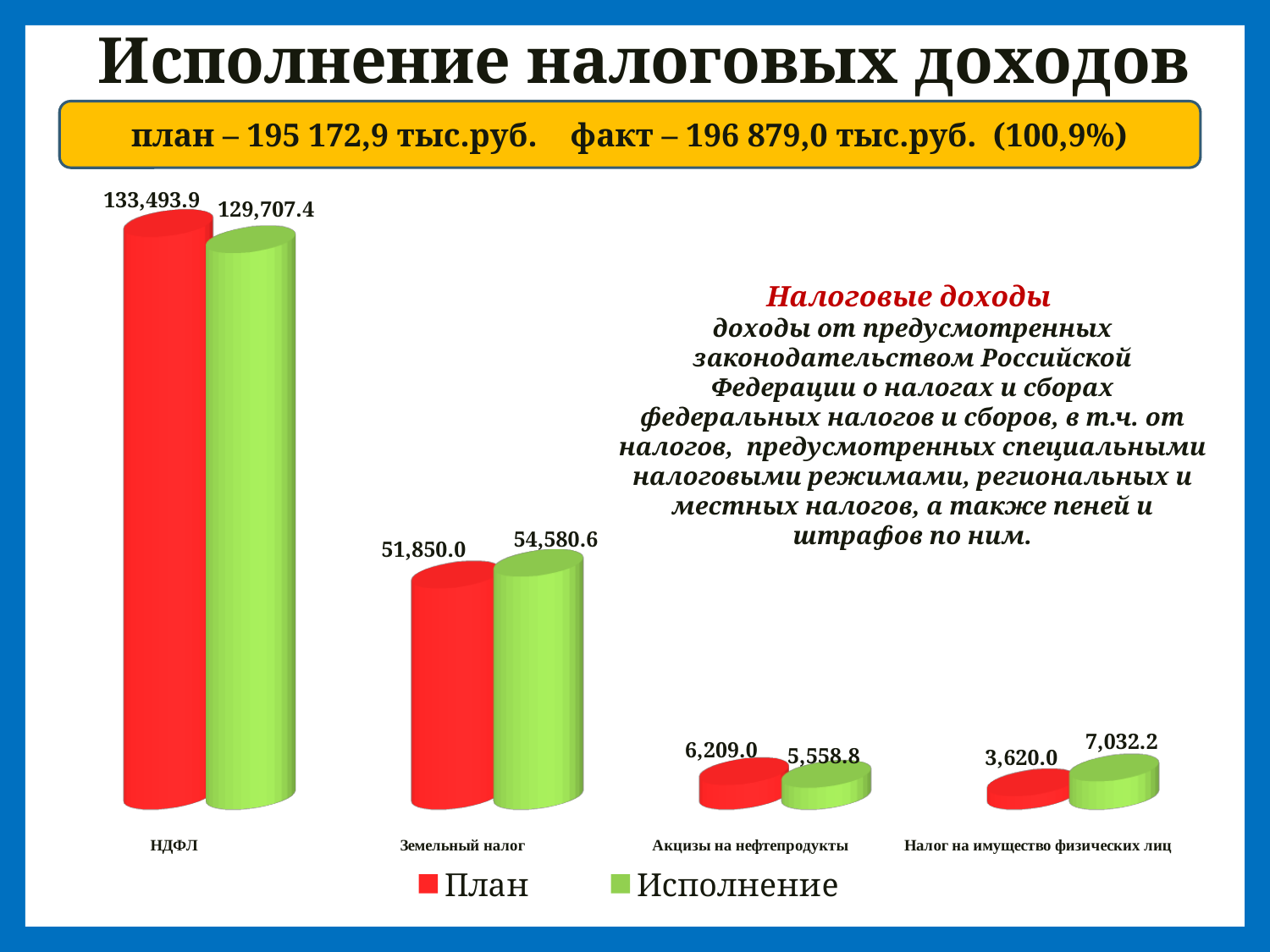
Which category has the lowest План value? Налог на имущество физических лиц What is the План value for НДФЛ? 133,493.9 What is the difference between the Исполнение and План values for Налог на имущество физических лиц? 3,412.2 What is the Исполнение value for Земельный налог? 54,580.6 What is the difference between the План and Исполнение values for НДФЛ? 3,786.5 How many series does the chart legend list? 2 For Акцизы на нефтепродукты, which is larger: План or Исполнение? План What is the Исполнение value for Налог на имущество физических лиц? 7,032.2 What kind of chart is shown on the slide? Bar chart How many categories are shown on the x axis of the chart? 4 What is the План value for Акцизы на нефтепродукты? 6,209.0 Which category has the highest Исполнение value? НДФЛ